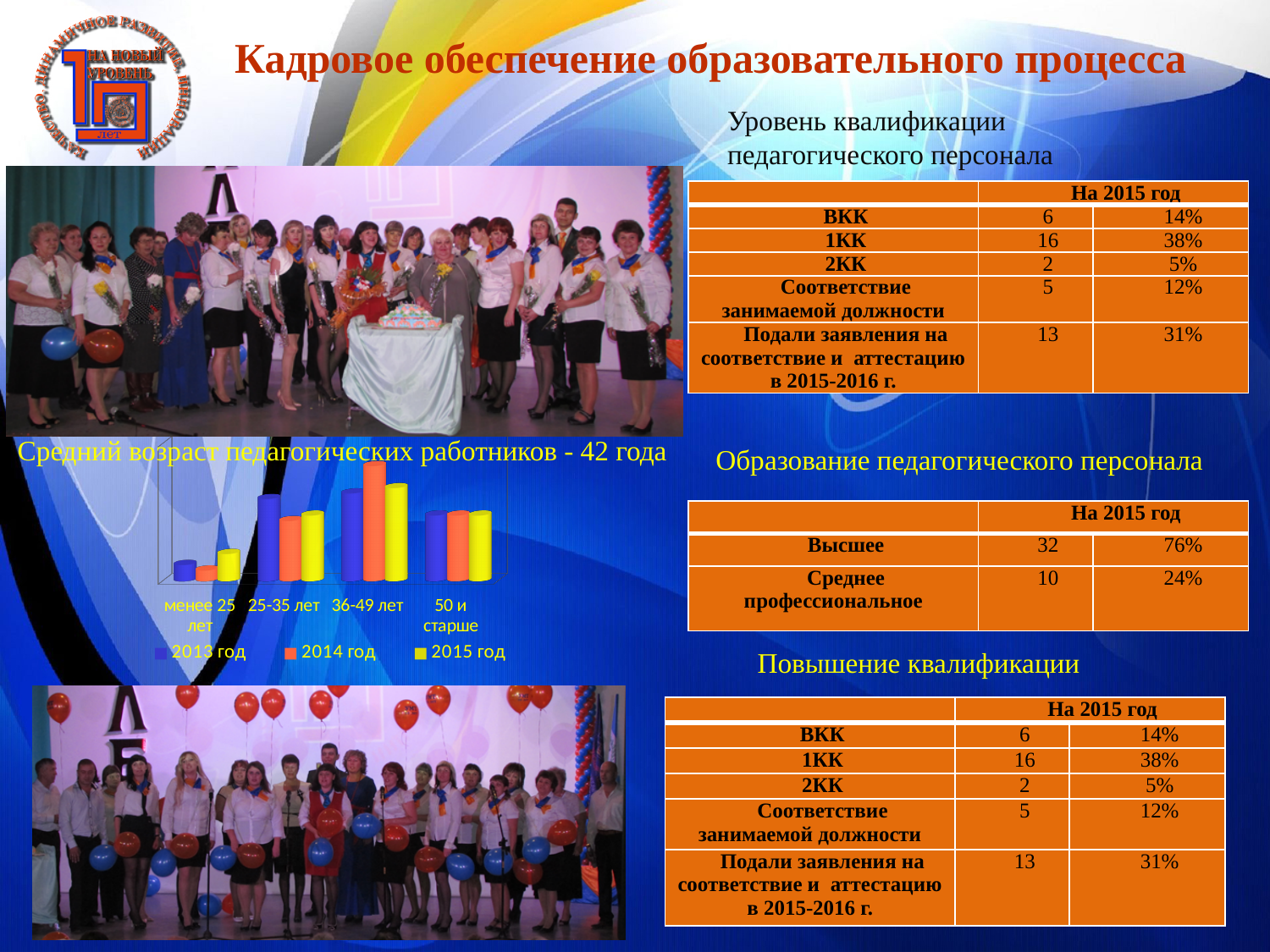
What kind of chart is shown on the slide? bar chart In the bar chart, which age category has the shortest bar for 2014 год? менее 25 лет In the bar chart, which age category has the tallest bar for 2014 год? 36-49 лет What colour are the bars for the 2015 год series in the bar chart? yellow In the bar chart, for the 2014 год series, is the bar for 36-49 лет or for 25-35 лет taller? 36-49 лет In the bar chart, which age category has the shortest bar for 2013 год? менее 25 лет In the bar chart, for the 25-35 лет category, is the bar for 2013 год or for 2014 год taller? 2013 год How many age categories are shown on the x axis of the bar chart? 4 How many series does the legend of the bar chart list? 3 In the bar chart, for the менее 25 лет category, is the bar for 2015 год or for 2014 год taller? 2015 год Which series are listed in the legend of the bar chart? 2013 год, 2014 год, 2015 год In the bar chart, which age category has the shortest bar for 2015 год? менее 25 лет